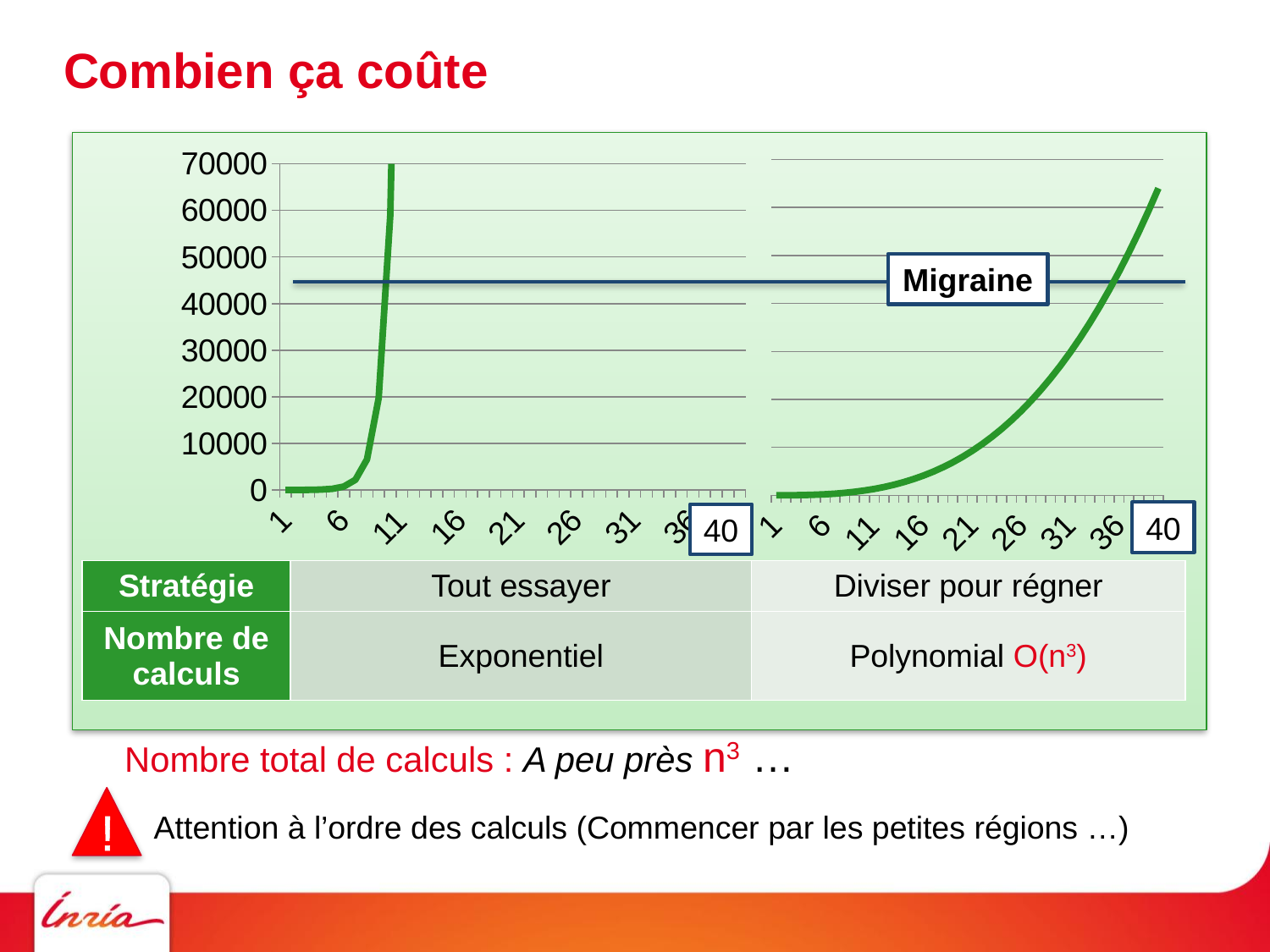
What label is given to the horizontal line drawn across both charts? Migraine What kind of chart is used on the slide to show the number of calculations? Line chart In the right chart (Diviser pour régner), is the value at x = 36 greater or less than 40000? greater In the left chart (Tout essayer), is the value at x = 6 greater or less than 10000? less What is the highest value shown on the y axis of the charts? 70000 In the right chart (Diviser pour régner), do the values rise or fall along the x axis? Rise In the right chart (Diviser pour régner), is the value at x = 16 greater or less than 10000? less At x = 11, which chart shows the larger value: the left chart (Tout essayer) or the right chart (Diviser pour régner)? Left chart (Tout essayer) Which strategy's curve reaches the Migraine line first (at a smaller x value)? Tout essayer In the left chart (Tout essayer), do the values rise or fall as the x axis goes from 1 to 40? Rise